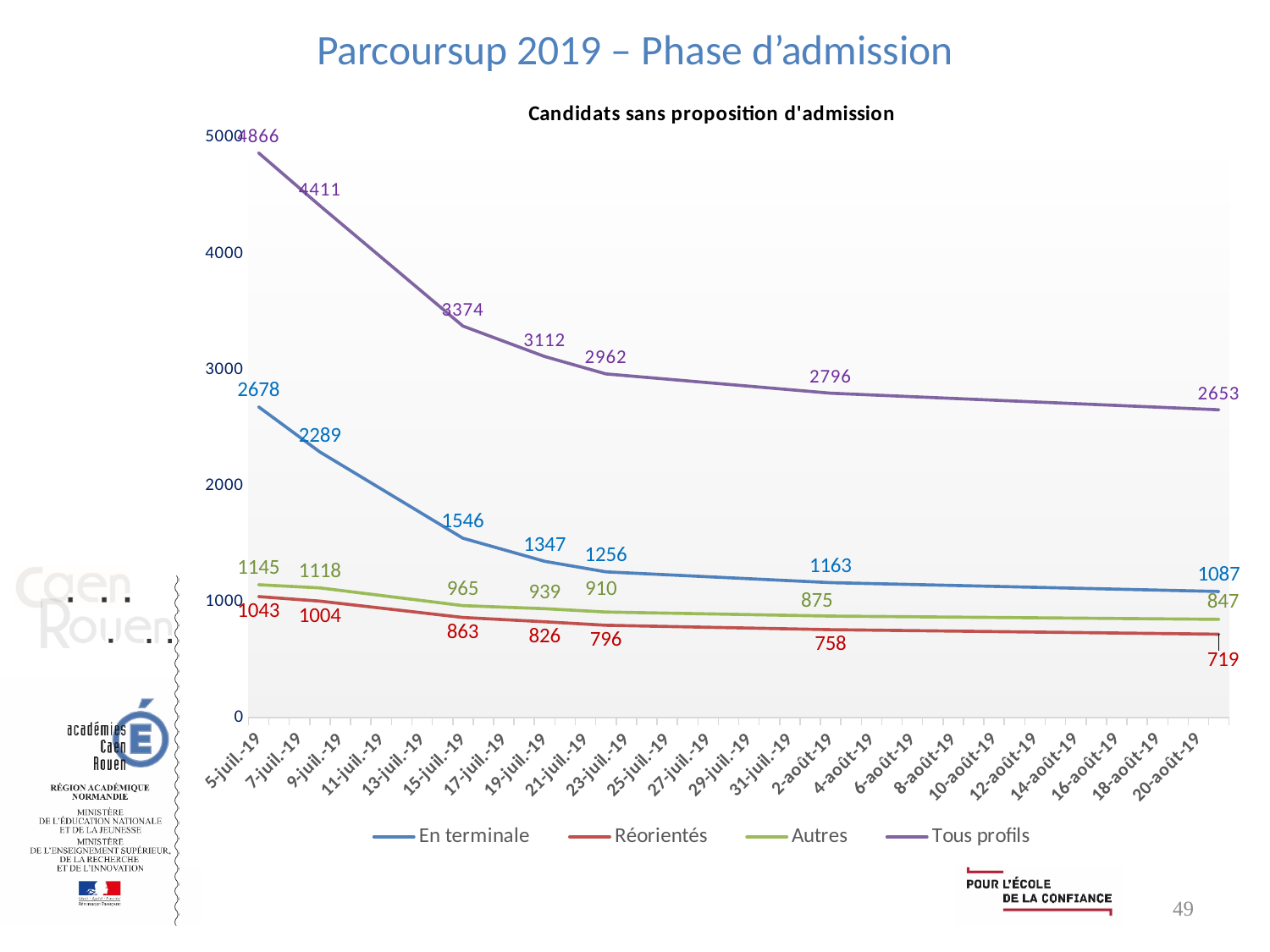
Which series has the highest values throughout the chart? Tous profils How many series does the legend list? 4 At 5-juil.-19, which is larger: the Autres value or the Réorientés value? Autres What is the last value shown for the En terminale series (at 20-août-19)? 1087 What is the value of the Autres series at 5-juil.-19? 1145 Do the values of the En terminale series rise or fall along the x axis? fall What is the difference between the first (4866) and last (2653) values of the Tous profils series? 2213 What is the last value shown for the Réorientés series (at 20-août-19)? 719 What is the first value shown for the Tous profils series (at 5-juil.-19)? 4866 What is the title of the chart? Candidats sans proposition d'admission Which series has the lowest values at 20-août-19? Réorientés What type of chart is shown on the slide? line chart